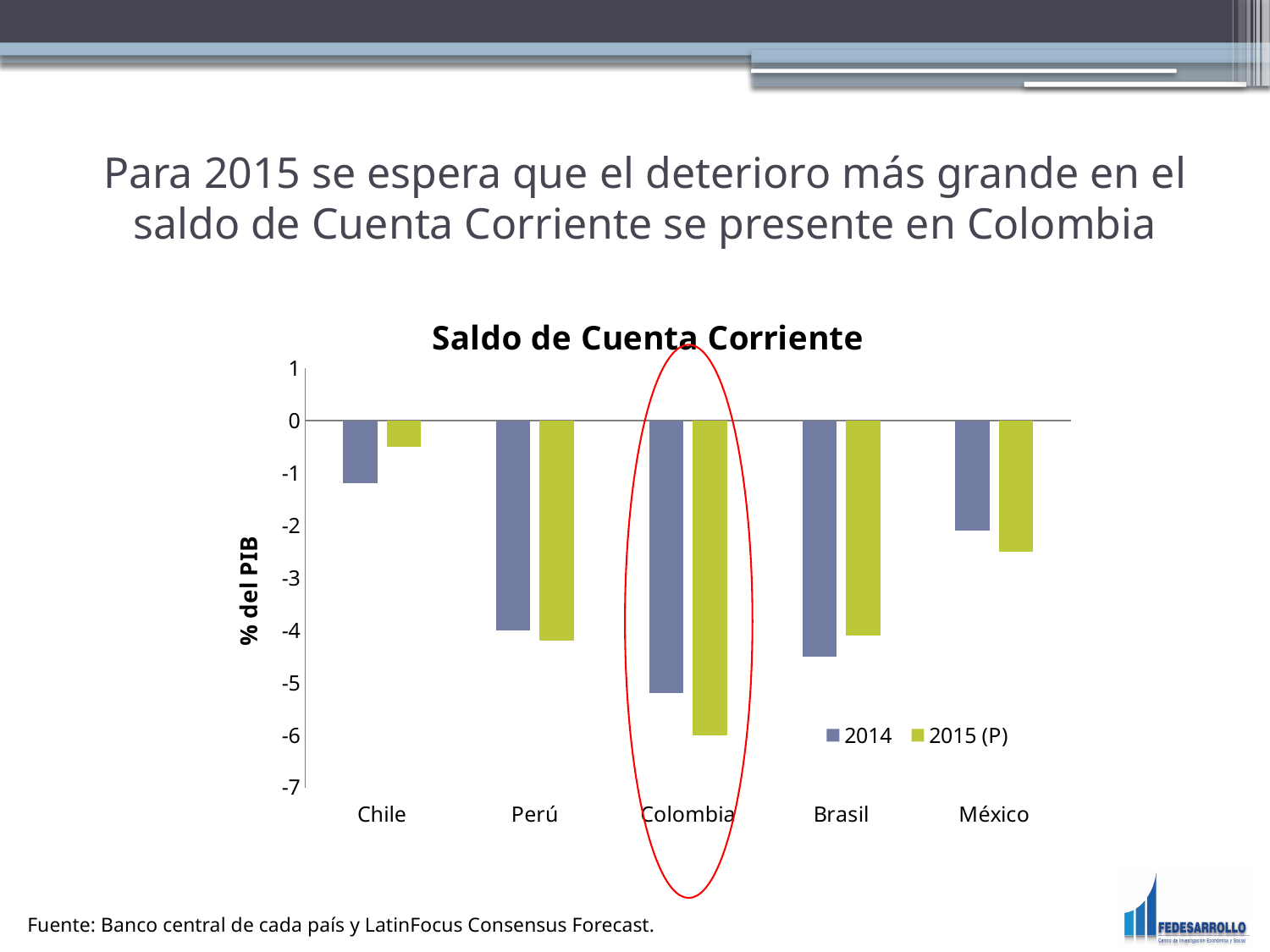
What is the label on the vertical axis of the chart? % del PIB Is the 2015 (P) value for Colombia greater or less than -5? less For Brasil, which is larger, the 2014 value or the 2015 (P) value? 2015 (P) For Colombia, which is larger, the 2014 value or the 2015 (P) value? 2014 How many countries are shown on the x axis of the chart? 5 Is the 2015 (P) value for Chile greater or less than -1? greater Which country has the lowest value for 2014? Colombia What kind of chart is shown on the slide? bar chart How many series does the chart's legend list? 2 Is the 2014 value for Chile greater or less than -1? less Which country has the lowest value for 2015 (P)? Colombia Which country has the highest value for 2015 (P)? Chile